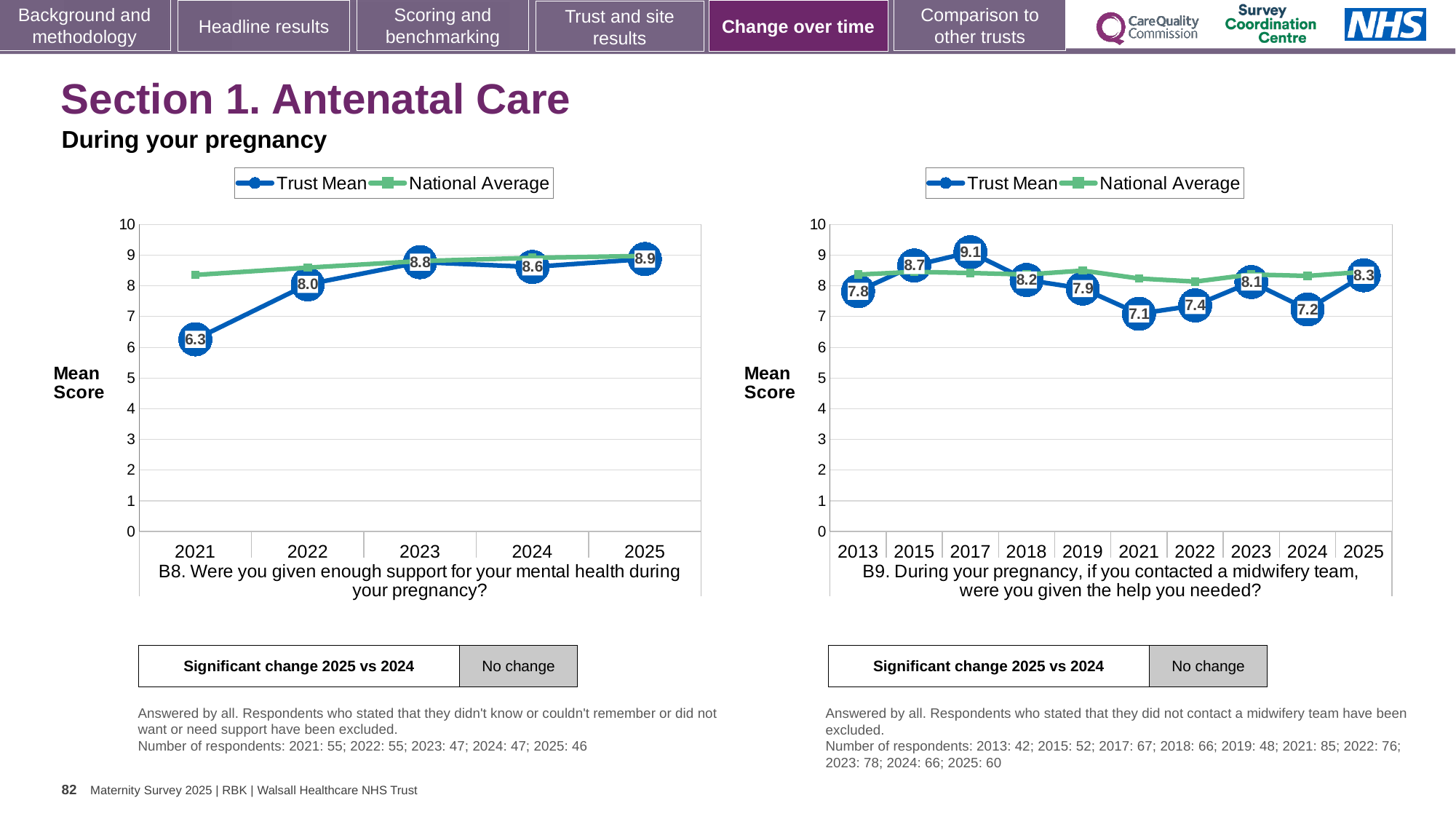
In the B8 chart (left), what is the difference between the Trust Mean for 2023 and 2021? 2.5 In the B8 chart (left), what is the Trust Mean for 2021? 6.3 In the B9 chart (right), which year has the highest Trust Mean? 2017 How many series does the legend of the B9 chart (right) list? 2 In the B8 chart (left), is the Trust Mean for 2021 greater or less than 7? less In the B8 chart (left), what is the Trust Mean for 2025? 8.9 In the B9 chart (right), which year has the lowest Trust Mean? 2021 In the B8 chart (left), which year has the lowest Trust Mean? 2021 In the B8 chart (left), how many years are plotted on the x axis? 5 In the B9 chart (right), what is the difference between the Trust Mean for 2025 and 2024? 1.1 In the B9 chart (right), is the Trust Mean higher in 2023 or 2024? 2023 In the B9 chart (right), what is the Trust Mean for 2017? 9.1